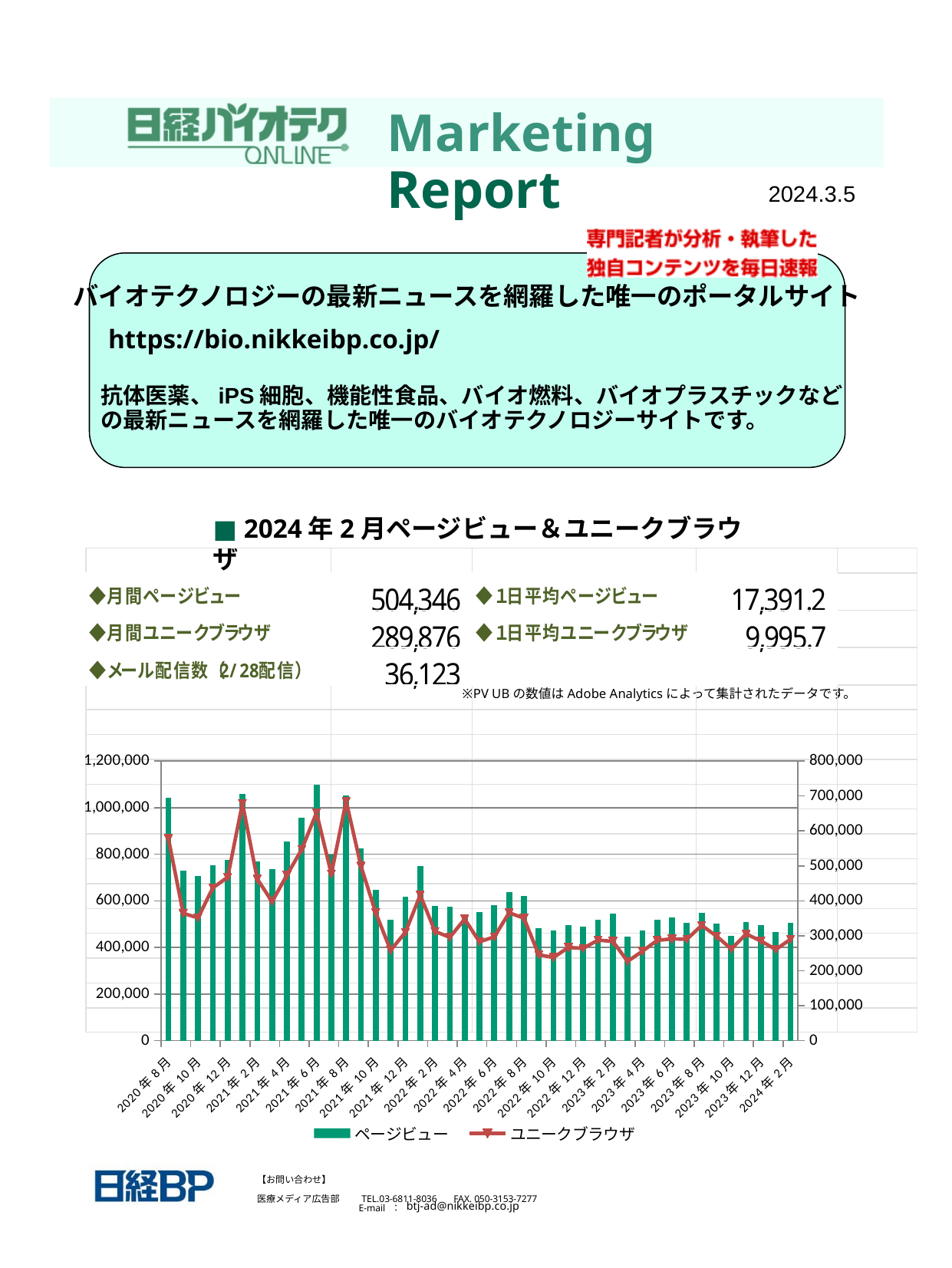
Which has the larger ページビュー value, 2021年6月 or 2022年6月? 2021年6月 Is the ユニークブラウザ value for 2024年2月 greater or less than 400,000 on the right axis? less Which series is drawn as a line in the chart? ユニークブラウザ How many series does the chart legend list? 2 Is the ページビュー value for 2020年8月 greater or less than 1,000,000? greater Is the ユニークブラウザ value for 2021年2月 greater or less than 600,000 on the right axis? less What kind of chart is shown on the slide? A combined bar and line chart Which has the larger ページビュー value, 2020年8月 or 2024年2月? 2020年8月 Which series is drawn as bars in the chart? ページビュー Do the ページビュー values generally rise or fall from 2021年8月 to 2024年2月? fall